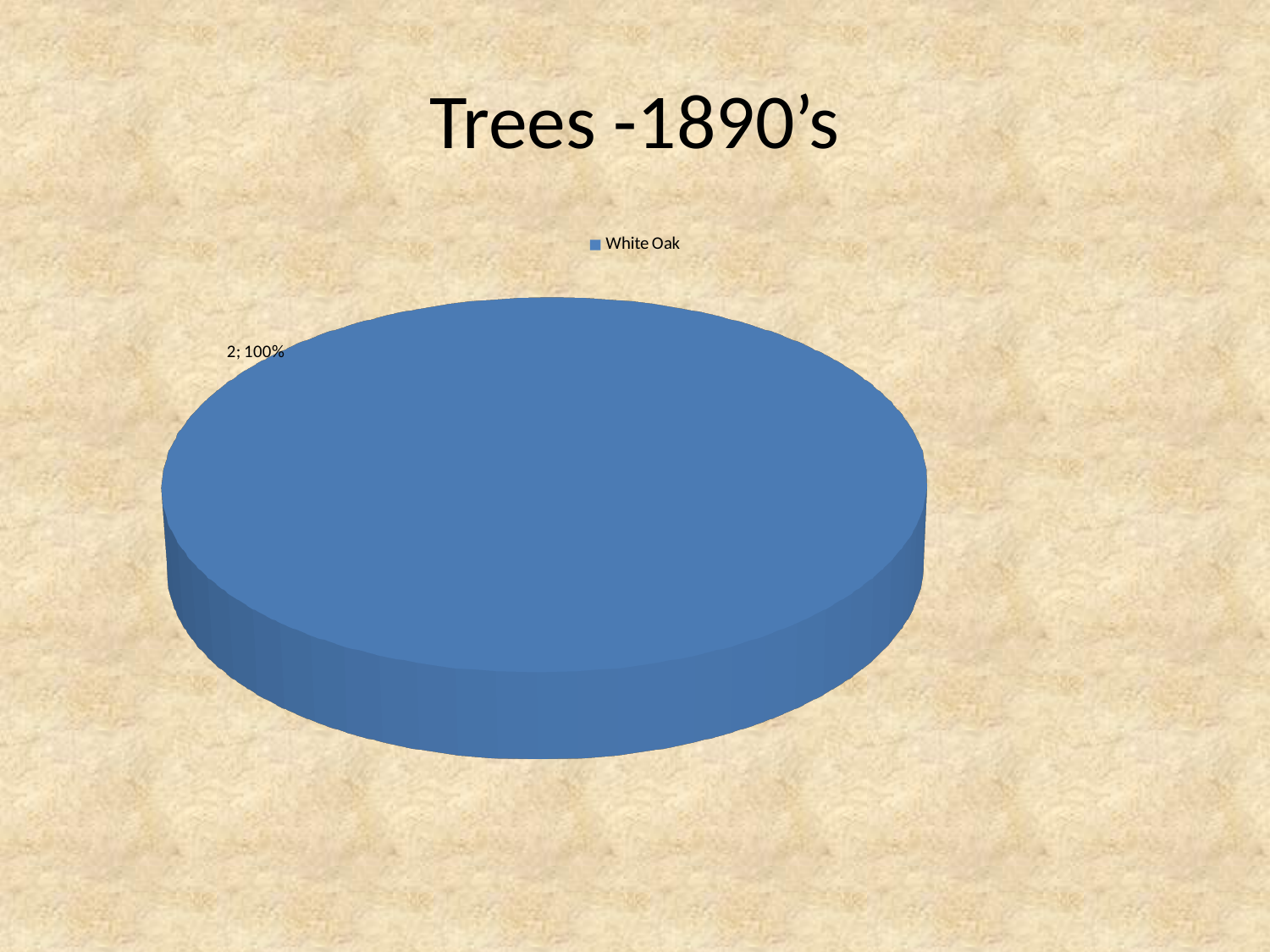
How many slices does the pie chart have? 1 What kind of chart is shown on the slide? pie chart What is the title of the slide? Trees -1890's What category is shown in the legend? White Oak Which category is the largest in the pie chart? White Oak What share of the pie does White Oak represent? 100% How many categories does the legend list? 1 What is the value for White Oak? 2